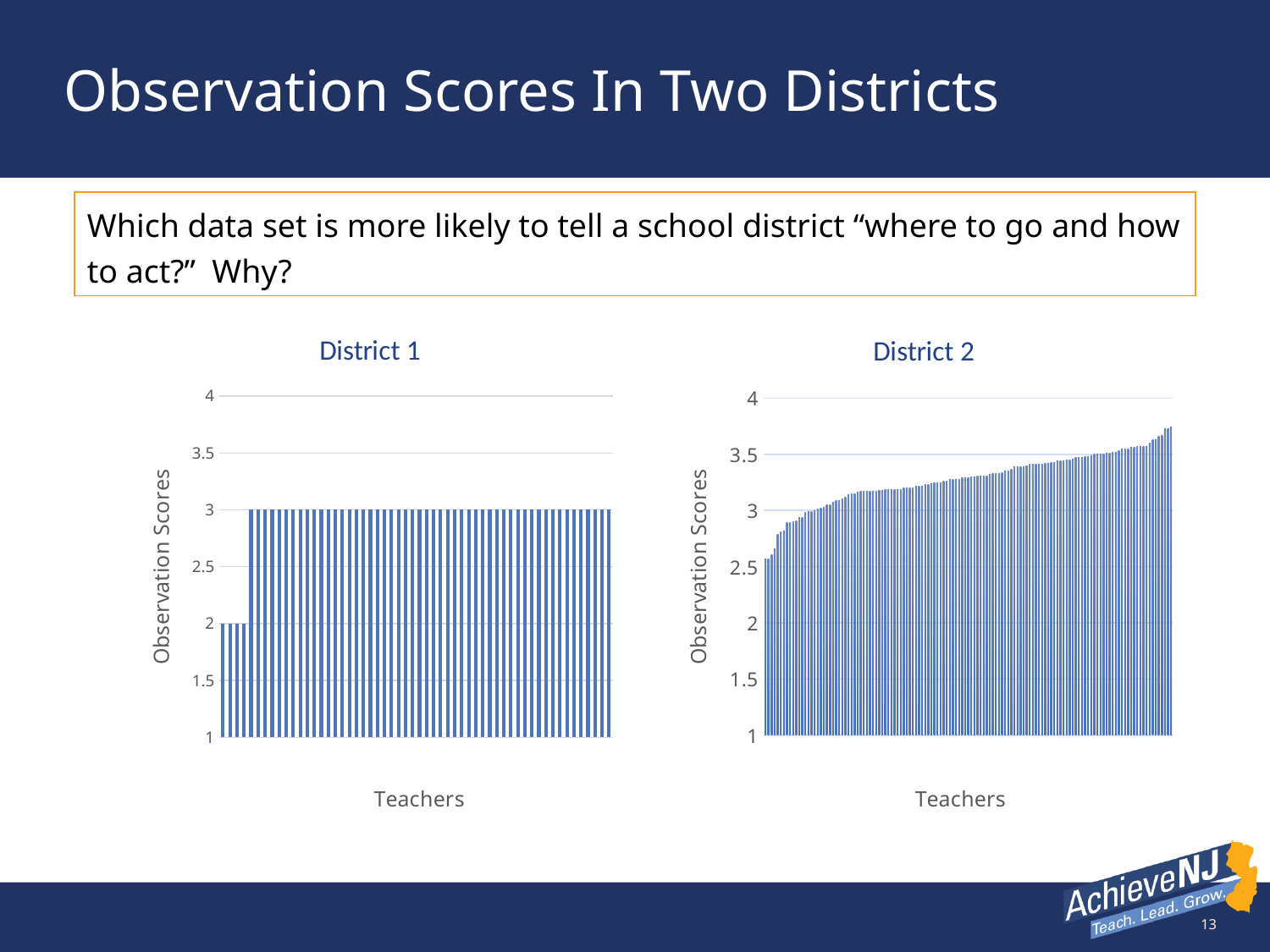
What is the label on the x axis of the District 1 chart? Teachers In the District 2 chart, is the value of the leftmost bar greater or less than 3? less In the District 2 chart, is the value of the rightmost bar greater or less than 3.5? greater What kind of chart is the District 2 chart? bar chart What is the label on the y axis of the District 2 chart? Observation Scores In the District 2 chart, is the value of the leftmost bar greater or less than 2.5? greater In the District 1 chart, what value do the first few bars on the left reach? 2 What kind of chart is the District 1 chart? bar chart In the District 2 chart, do the values rise or fall from left to right along the x axis? rise In the District 1 chart, what value do most of the bars reach? 3 In the District 1 chart, which is larger, the value of the leftmost bar or the value of the rightmost bar? the rightmost bar